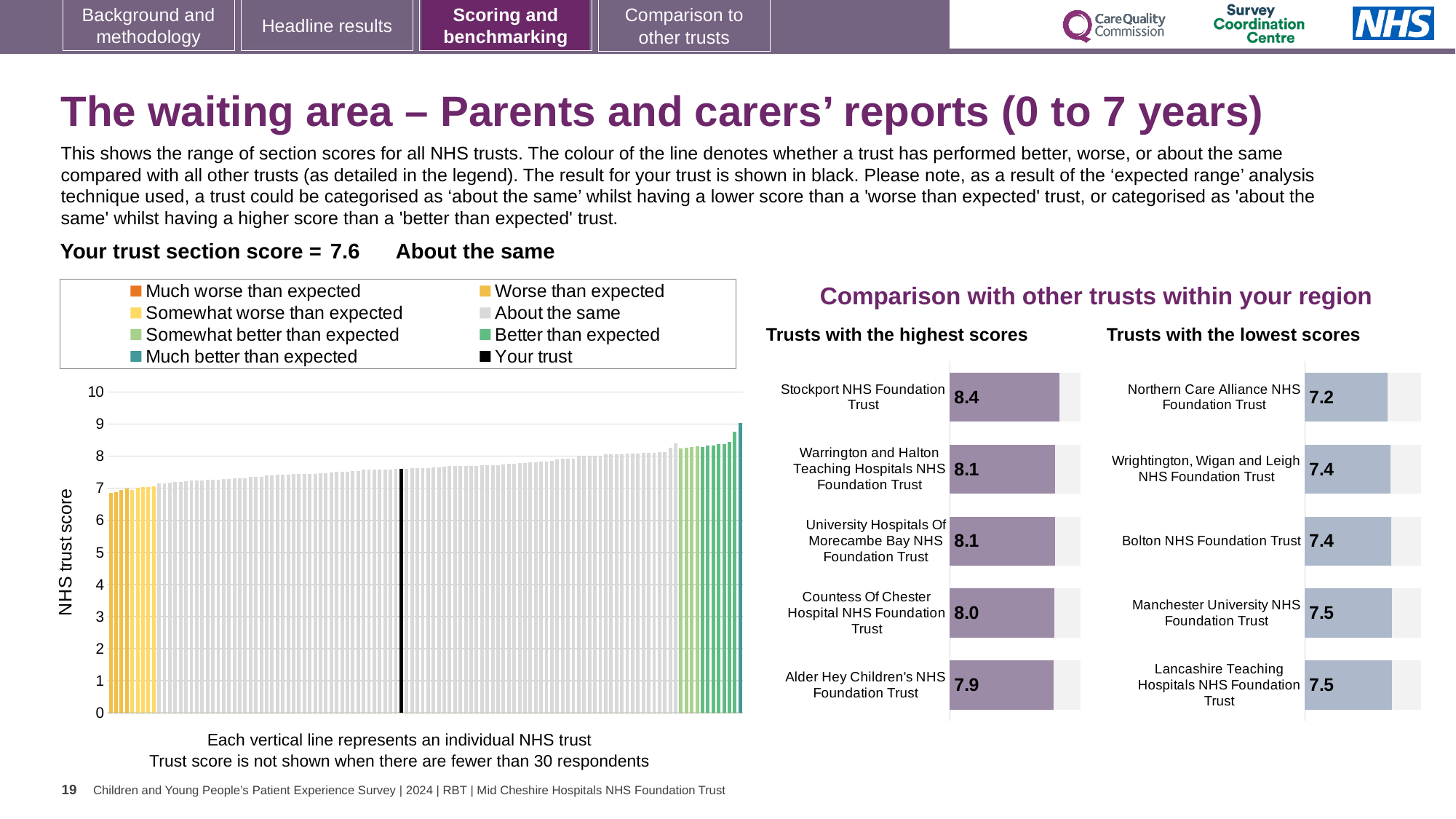
In the 'Trusts with the highest scores' chart, which has the higher score: Countess Of Chester Hospital NHS Foundation Trust or Alder Hey Children's NHS Foundation Trust? Countess Of Chester Hospital NHS Foundation Trust In the main 'NHS trust score' chart on the left, do the trust scores rise or fall from left to right? rise In the 'Trusts with the highest scores' chart, which trust has the lowest score shown? Alder Hey Children's NHS Foundation Trust In the 'Trusts with the lowest scores' chart, which trust has the lowest score? Northern Care Alliance NHS Foundation Trust In the main 'NHS trust score' chart on the left, is the highest trust score greater or less than 8? greater In the 'Trusts with the highest scores' chart, what is the score for Stockport NHS Foundation Trust? 8.4 How many trusts are listed in the 'Trusts with the lowest scores' chart? 5 How many entries does the legend above the main 'NHS trust score' chart list? 8 In the 'Trusts with the lowest scores' chart, what is the score for Northern Care Alliance NHS Foundation Trust? 7.2 In the main 'NHS trust score' chart on the left, what is the section score for your trust (the black line)? 7.6 In the 'Trusts with the lowest scores' chart, what is the difference between the scores of Lancashire Teaching Hospitals NHS Foundation Trust and Northern Care Alliance NHS Foundation Trust? 0.3 In the 'Trusts with the highest scores' chart, what is the difference between the scores of Stockport NHS Foundation Trust and Alder Hey Children's NHS Foundation Trust? 0.5